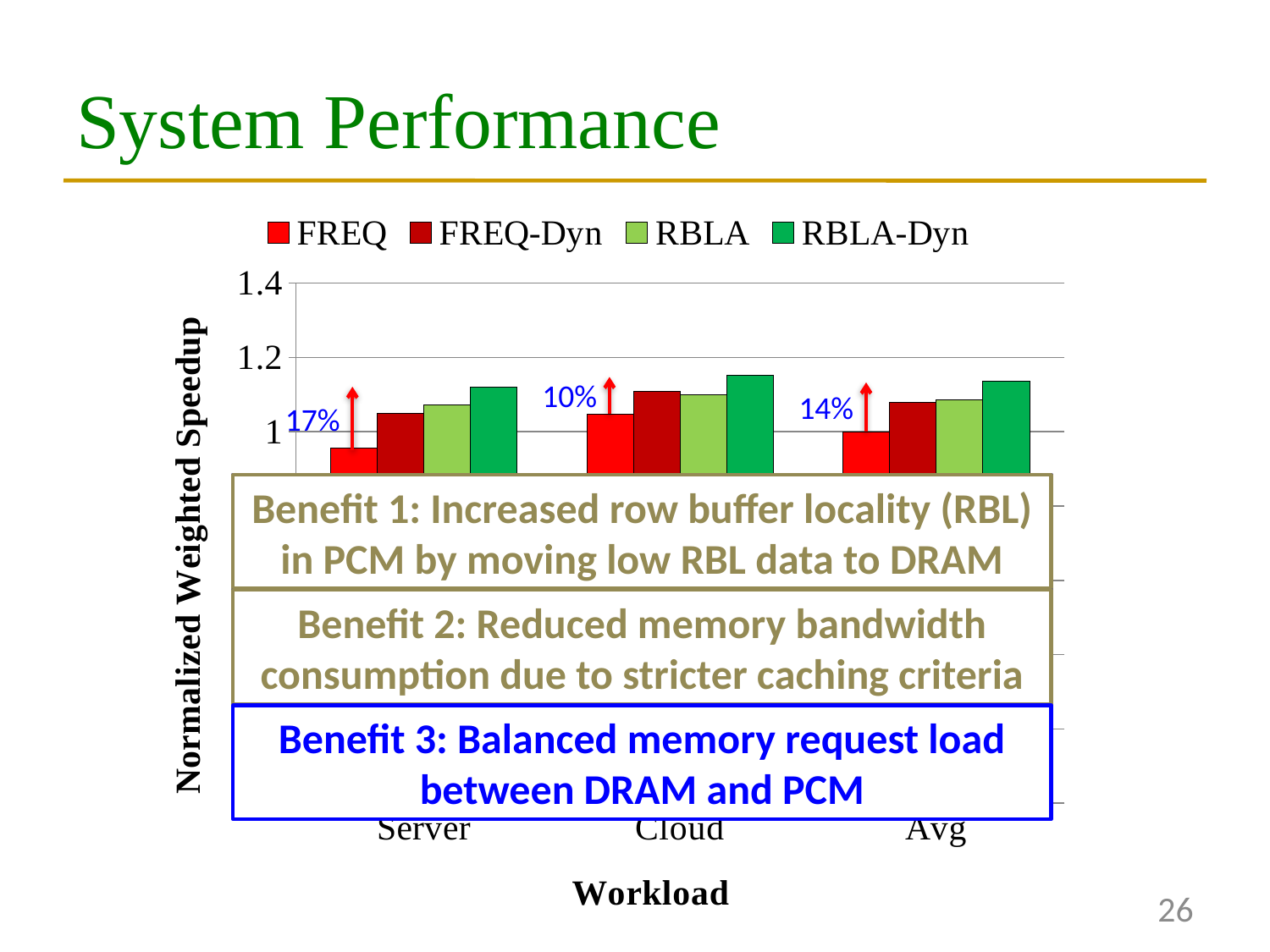
What is the title of the x axis? Workload What percentage improvement is annotated above the Server workload group? 17% How many series does the legend list? 4 What is the title of the y axis? Normalized Weighted Speedup Is the RBLA-Dyn value for the Cloud workload greater or less than 1.2? less How many workload categories are shown on the x axis? 3 Is the FREQ value for the Server workload greater or less than 1? less Which series has the highest bar for the Avg workload? RBLA-Dyn What kind of chart is shown on the slide? bar chart For the Avg workload, which is larger: the FREQ bar or the RBLA-Dyn bar? RBLA-Dyn Which series has the highest bar for the Server workload? RBLA-Dyn Which series has the lowest bar for the Cloud workload? FREQ